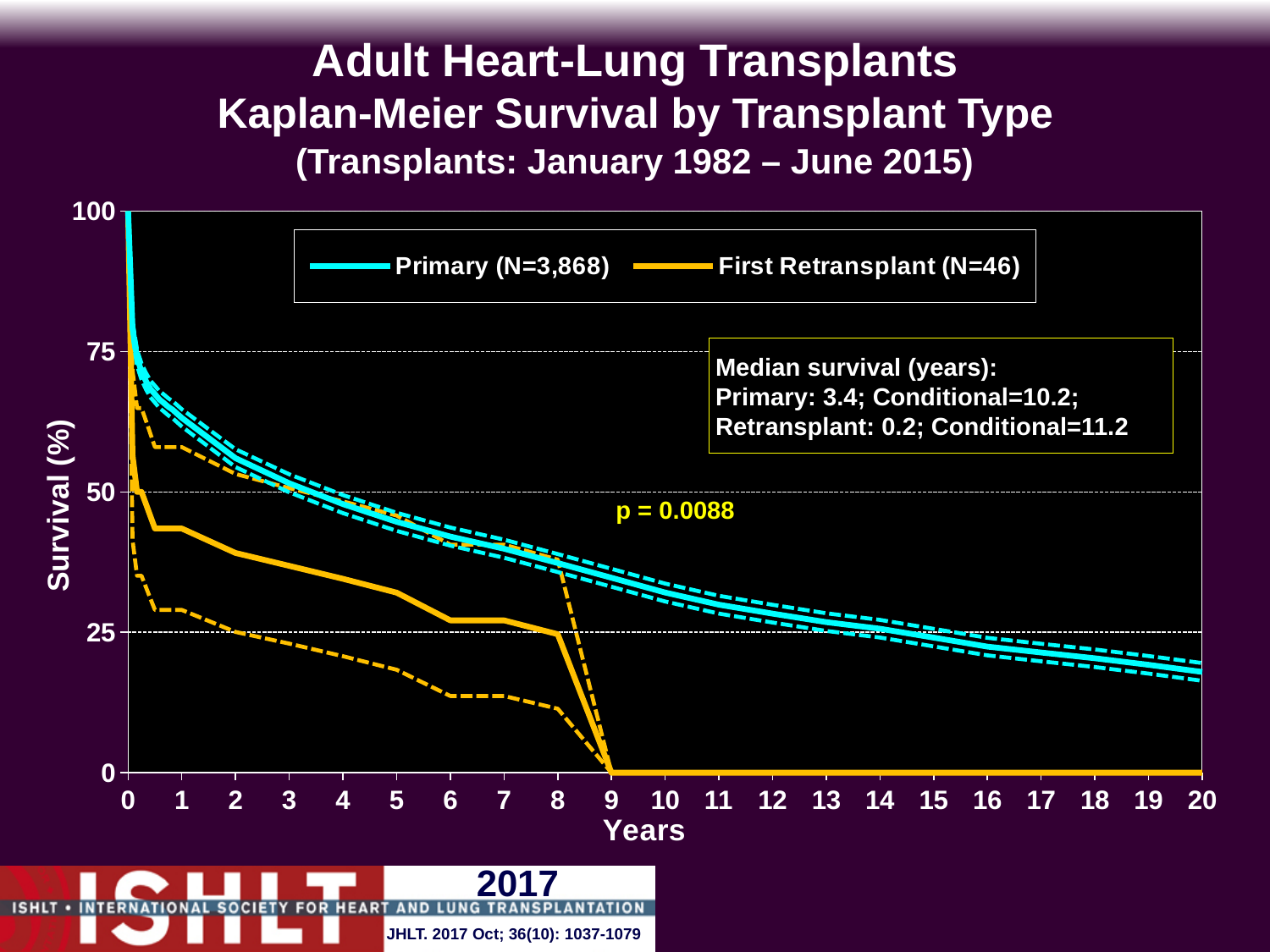
What is the N for the First Retransplant group shown in the legend? 46 What is the conditional median survival in years for Retransplant, as stated on the slide? 11.2 Is the survival for the First Retransplant group at 10 years greater or less than 25%? less Do the survival curves rise or fall as years increase? Fall What kind of chart is shown on the slide? Line chart What p-value is shown on the chart? p = 0.0088 Is the survival for the Primary group at 10 years greater or less than 50%? less What is the N for the Primary group shown in the legend? 3,868 How many series does the legend list? 2 At 5 years, which group has higher survival, Primary or First Retransplant? Primary Is the survival for the Primary group at 1 year greater or less than 50%? greater What is the median survival in years for Primary transplants, as stated on the slide? 3.4